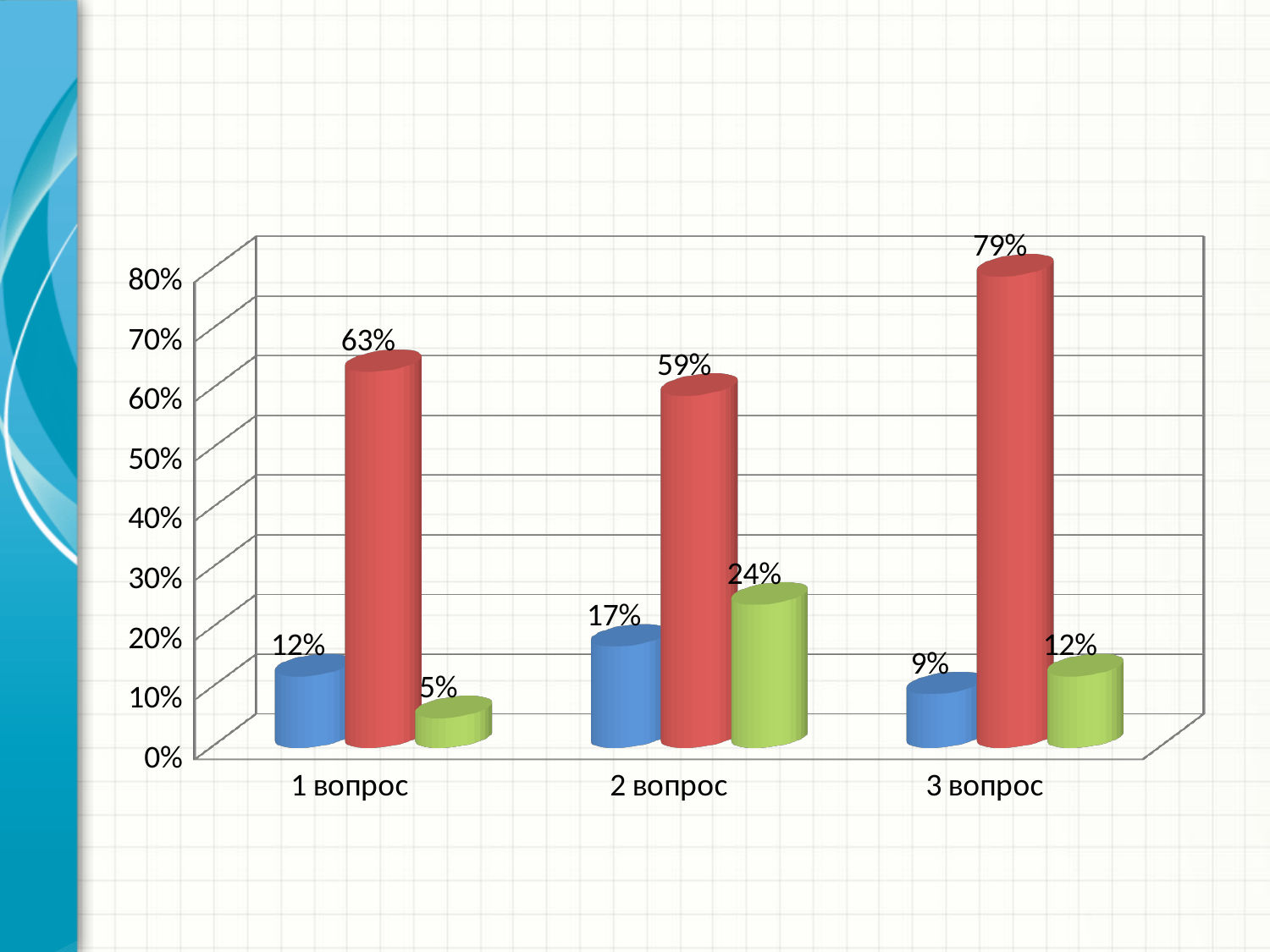
What is the value of the blue bar for 3 вопрос? 9% Which is larger: the blue bar for 2 вопрос or the green bar for 2 вопрос? the green bar for 2 вопрос Which category has the highest red bar? 3 вопрос What is the value of the red bar for 1 вопрос? 63% What is the difference between the red bar for 3 вопрос and the red bar for 2 вопрос? 20% Do the values of the blue bars rise or fall from 2 вопрос to 3 вопрос? fall What is the value of the green bar for 2 вопрос? 24% What kind of chart is shown on the slide? bar chart Which category has the lowest blue bar? 3 вопрос What is the value of the green bar for 1 вопрос? 5% How many categories are shown on the x axis? 3 Is the red bar for 1 вопрос greater or less than 60%? greater